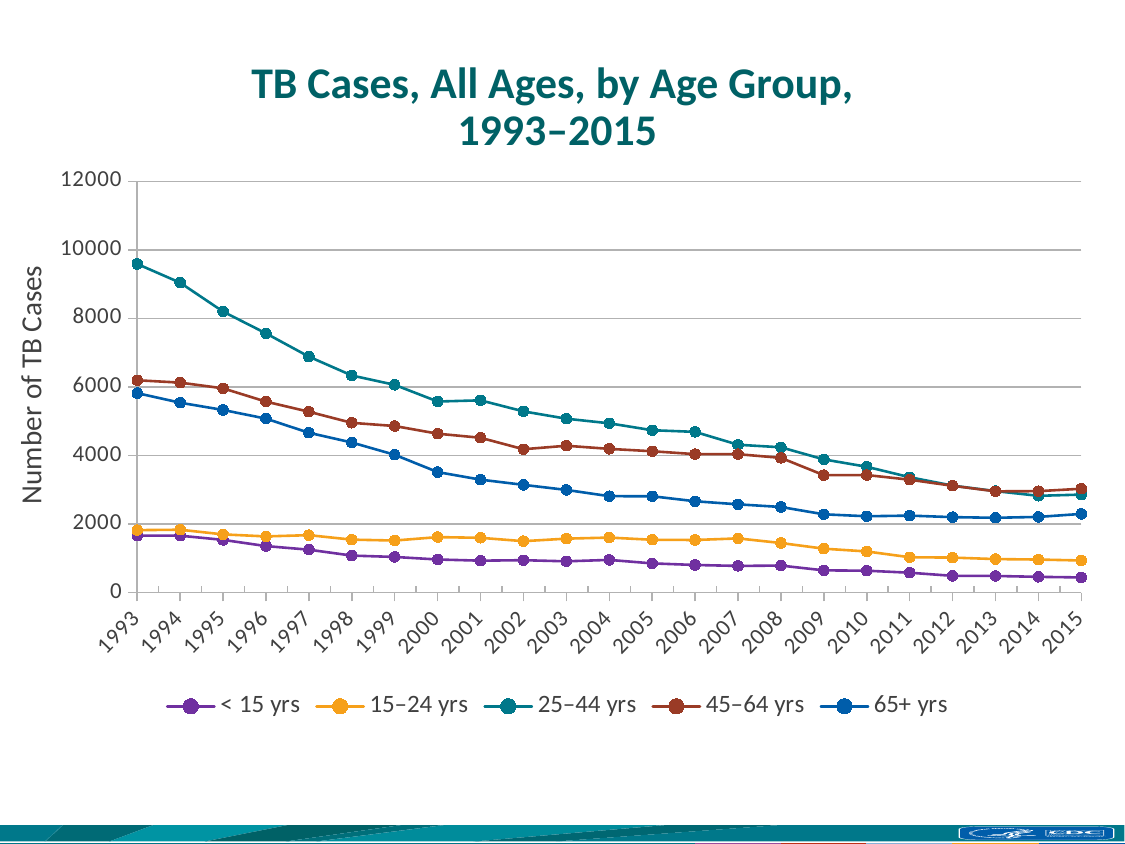
Is the value for < 15 yrs in 2015 greater or less than 1000? less What is the label on the y axis? Number of TB Cases How many series does the legend list? 5 Which age group has the lowest number of TB cases in 2015? < 15 yrs Is the value for 65+ yrs in 1993 greater or less than 4000? greater What is the title of the chart? TB Cases, All Ages, by Age Group, 1993–2015 Which age group has the highest number of TB cases in 1993? 25–44 yrs In 2015, which is larger: the value for 45–64 yrs or the value for 65+ yrs? 45–64 yrs How many years are plotted along the x axis? 23 Do the values for the 25–44 yrs series rise or fall from 1993 to 2015? fall What kind of chart is shown on the slide? line chart Is the value for 25–44 yrs in 1993 greater or less than 8000? greater